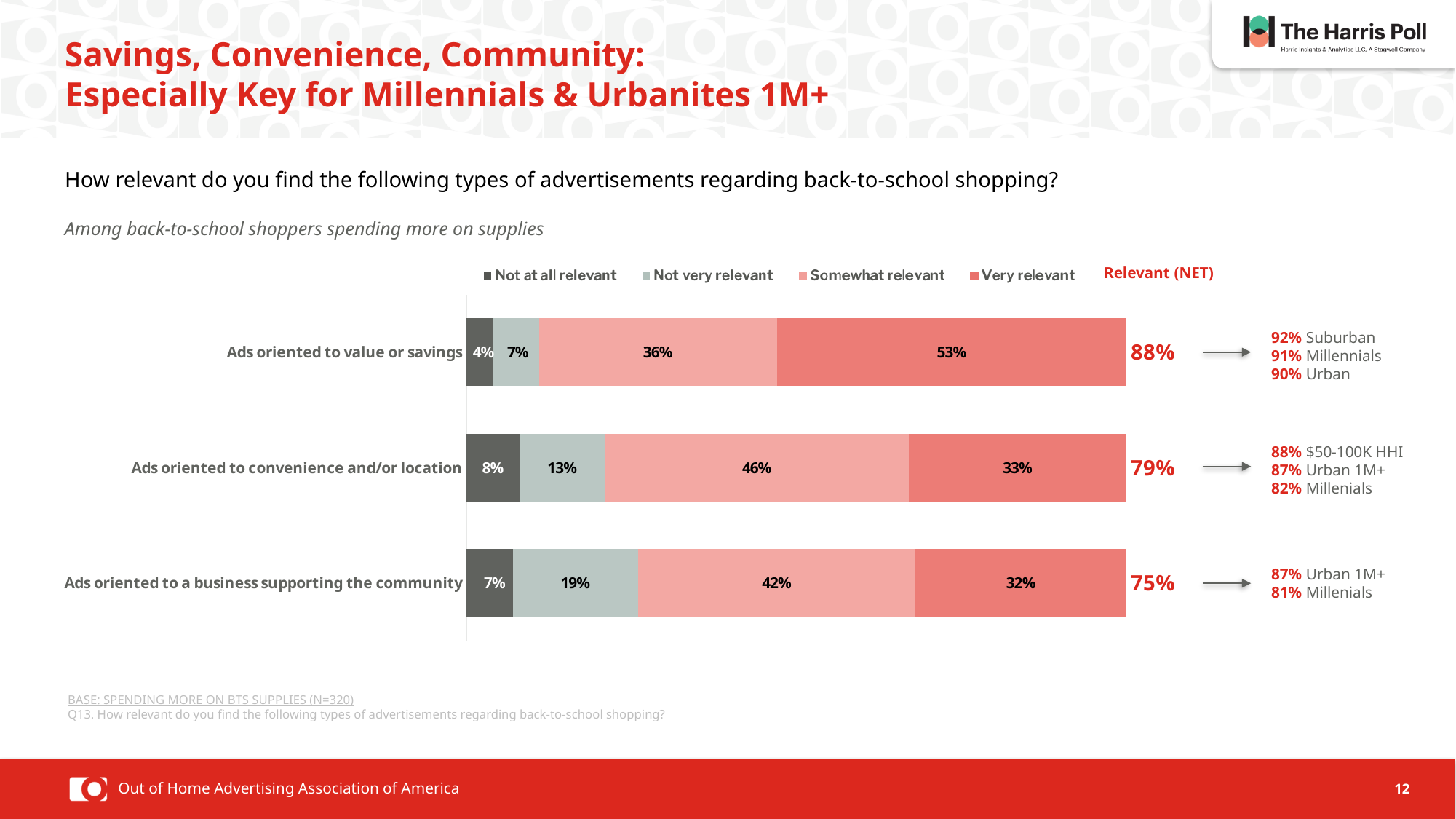
Which is larger: the 'Not at all relevant' share for ads oriented to convenience and/or location or for ads oriented to a business supporting the community? Ads oriented to convenience and/or location What kind of chart is shown on the slide? Stacked bar chart What is the combined 'Somewhat relevant' and 'Very relevant' total for ads oriented to a business supporting the community? 74% Which type of advertisement has the highest Relevant (NET) value? Ads oriented to value or savings What is the Relevant (NET) value for ads oriented to convenience and/or location? 79% What percentage of respondents found ads oriented to value or savings very relevant? 53% What percentage of respondents found ads oriented to a business supporting the community not very relevant? 19% What is the difference between the 'Very relevant' percentages for ads oriented to value or savings and ads oriented to convenience and/or location? 20 percentage points How many series does the chart legend list? 4 Which type of advertisement has the lowest 'Very relevant' percentage? Ads oriented to a business supporting the community How many types of advertisements are shown in the chart? 3 What percentage of respondents found ads oriented to convenience and/or location somewhat relevant? 46%